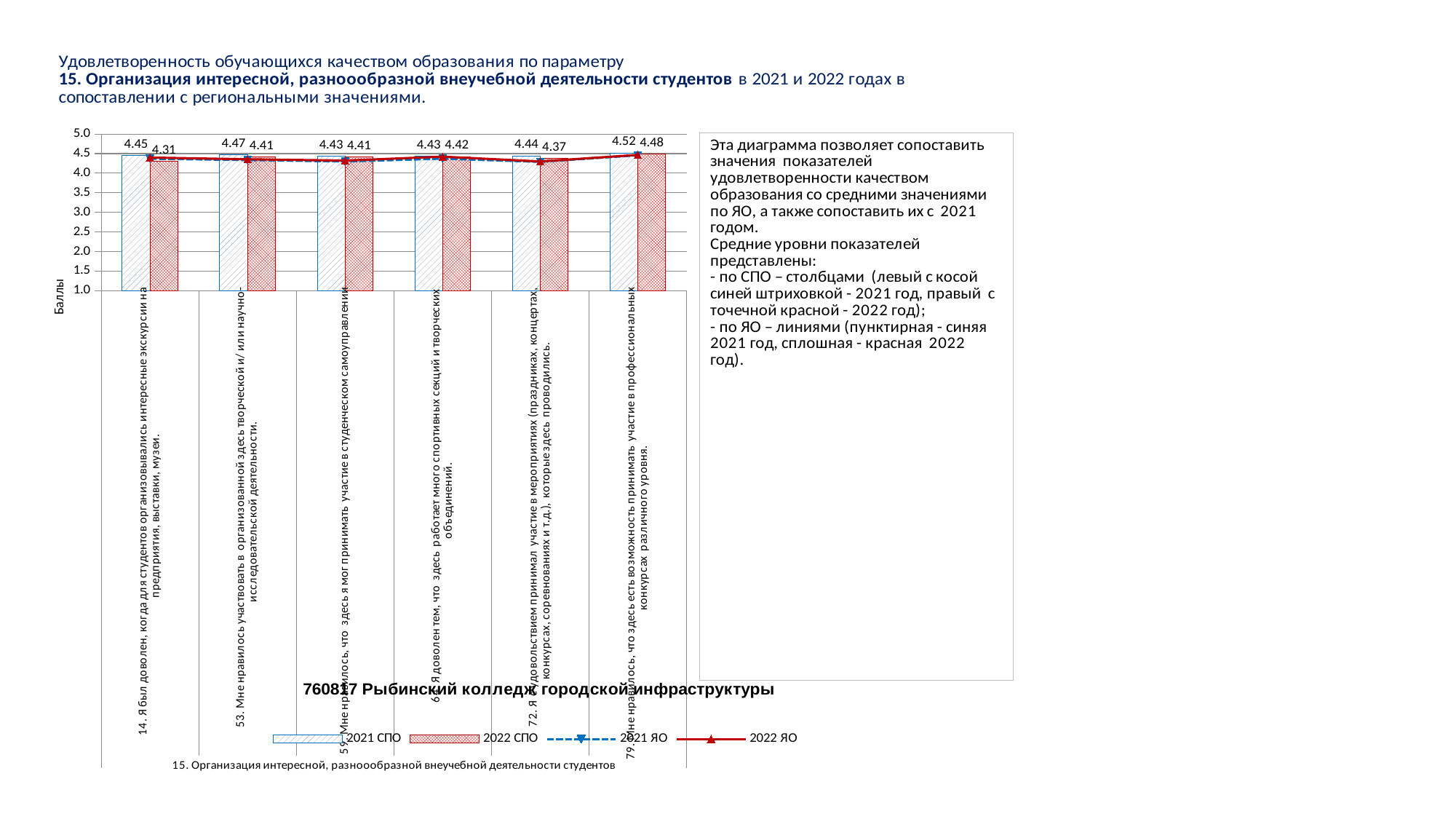
What is the 2021 СПО value for category 53 (creative and/or research activity)? 4.47 Which category has the lowest 2022 СПО value? 14. Я был доволен, когда для студентов организовывались интересные экскурсии на предприятия, выставки, музеи How many series does the chart legend list? 4 How many categories (questions) are shown on the x axis of the chart? 6 What is the label of the vertical axis of the chart? Баллы What is the 2022 СПО value for category 79 (participation in professional competitions of various levels)? 4.48 What is the 2021 СПО value for category 14 (excursions to enterprises, exhibitions, museums)? 4.45 For category 72 (participation in events such as holidays, concerts, competitions), which is larger: the 2021 СПО value or the 2022 СПО value? 2021 СПО Which category has the highest 2021 СПО value? 79. Мне нравилось, что здесь есть возможность принимать участие в профессиональных конкурсах различного уровня What is the difference between the 2021 СПО and 2022 СПО values for category 14? 0.14 What is the 2022 СПО value for category 14 (excursions to enterprises, exhibitions, museums)? 4.31 Is the 2022 СПО value for category 72 greater or less than 4.0? greater